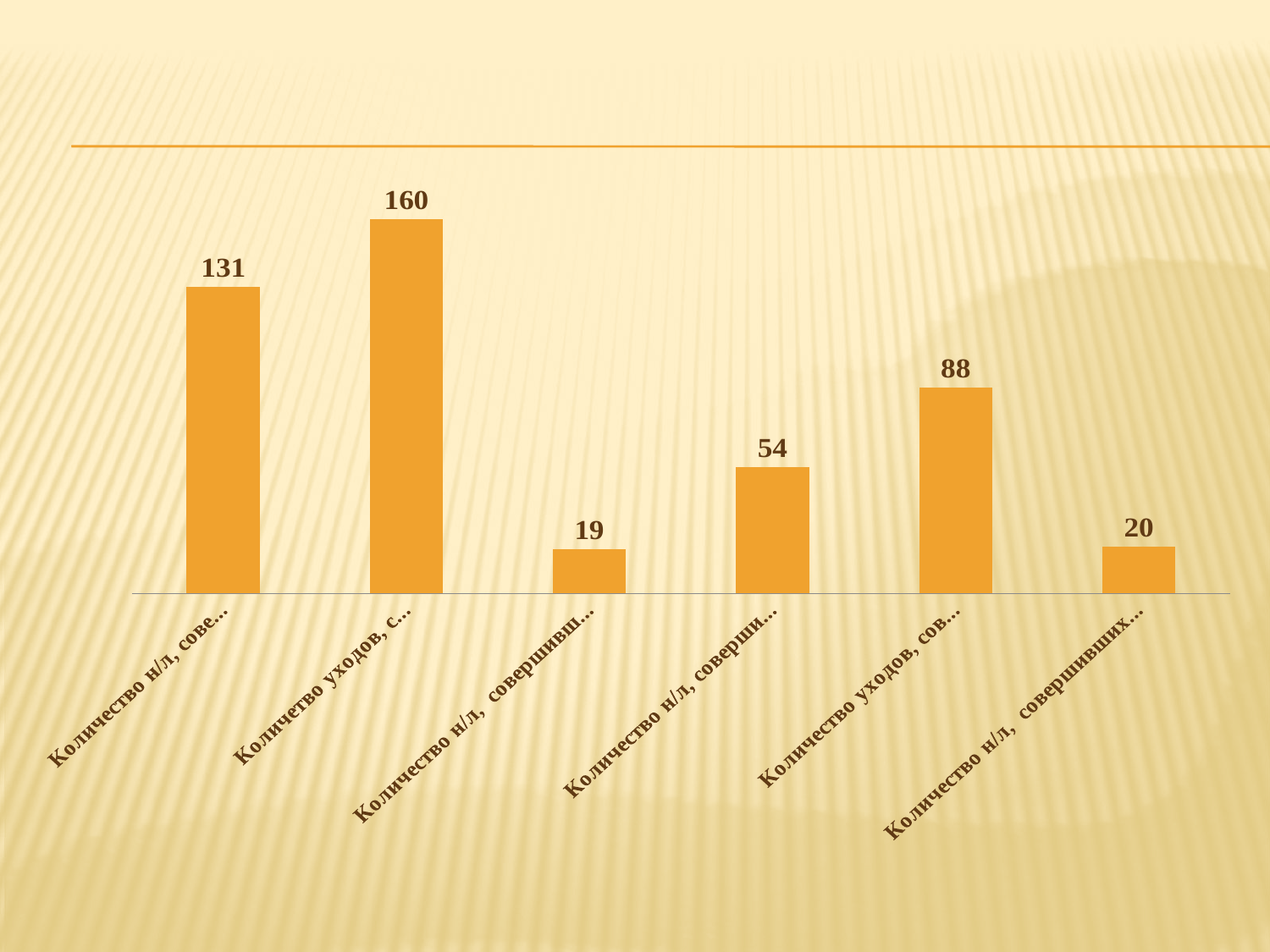
What is the value of the third bar from the left? 19 What is the value of the last bar on the right? 20 What is the value of the fifth bar from the left? 88 What is the lowest value shown in the chart? 19 What kind of chart is shown on the slide? bar chart What is the highest value shown in the chart? 160 Which is larger, the fifth bar from the left or the fourth bar from the left? the fifth bar (88) How many bars does the chart have? 6 What is the value of the fourth bar from the left? 54 What is the value of the second bar from the left? 160 What is the value of the first bar from the left? 131 What is the difference between the second bar (160) and the first bar (131)? 29